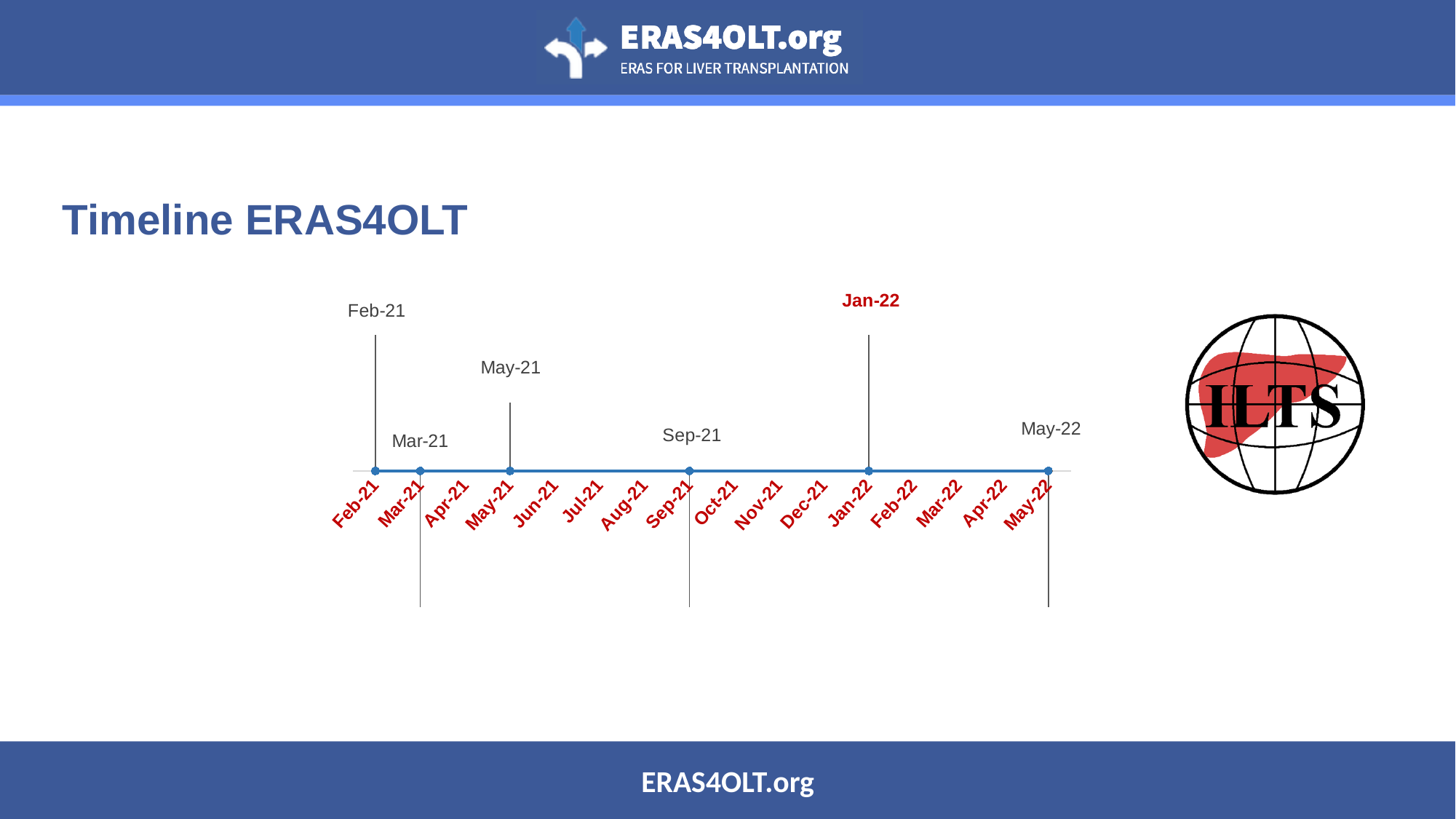
How many month labels are shown along the x axis of the timeline? 16 What is the latest milestone on the timeline? May-22 What is the last month label on the x axis of the timeline? May-22 What kind of chart is shown on the slide? Timeline chart Which milestone label is shown in red above the timeline? Jan-22 Which milestone comes immediately before Jan-22 on the timeline? Sep-21 How many milestone markers are plotted on the timeline? 6 Which milestone comes immediately after Mar-21 on the timeline? May-21 What is the title of the chart on the slide? Timeline ERAS4OLT Which milestone is earlier on the timeline, Sep-21 or Jan-22? Sep-21 What is the earliest milestone on the timeline? Feb-21 What is the first month label on the x axis of the timeline? Feb-21